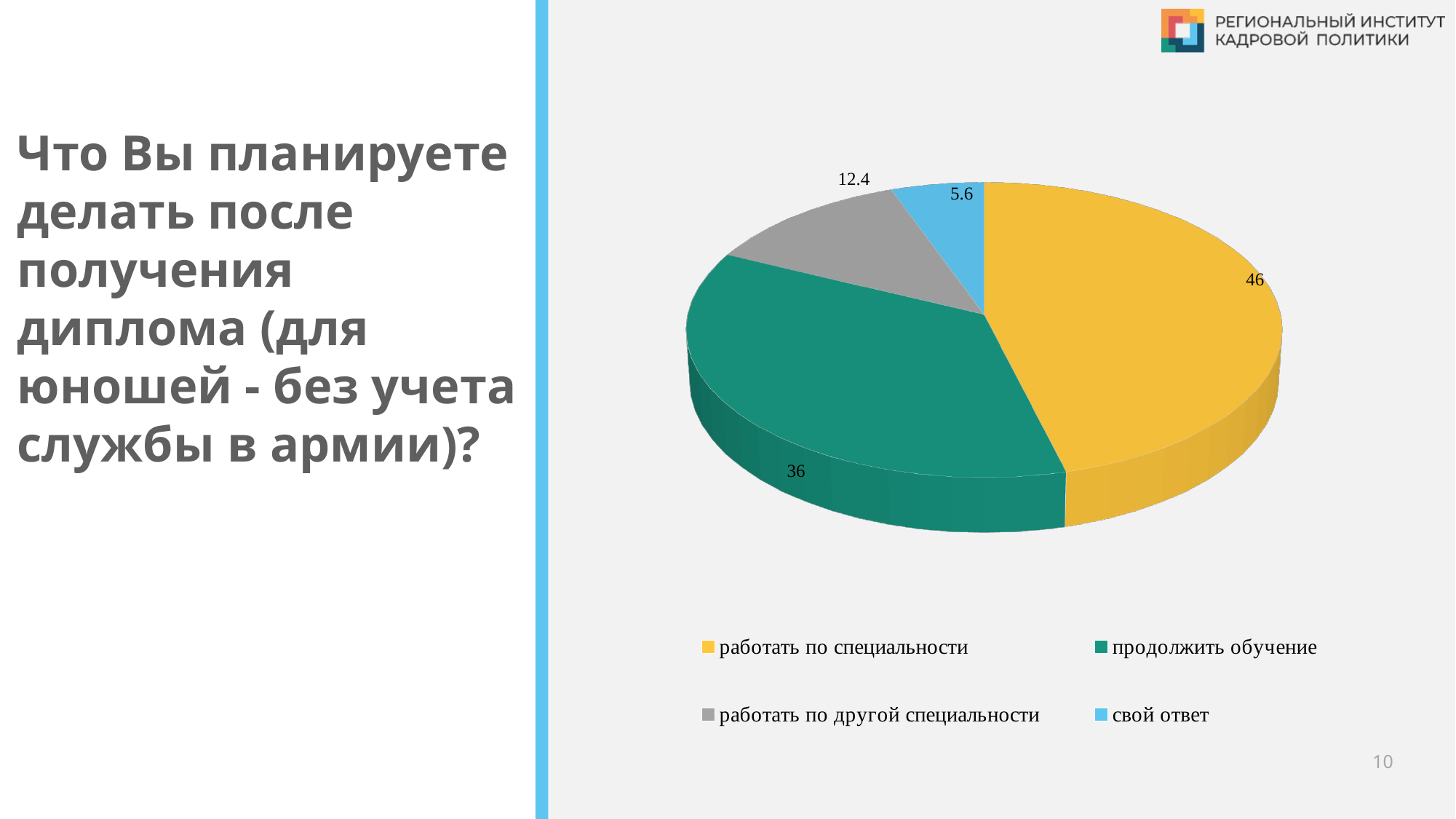
What is the value for "свой ответ"? 5.6 Which is larger: the value for "продолжить обучение" or the value for "работать по другой специальности"? продолжить обучение How many categories does the pie chart have? 4 What is the value for "продолжить обучение"? 36 What is the difference between the values for "работать по другой специальности" and "свой ответ"? 6.8 What is the value for "работать по другой специальности"? 12.4 Which category has the largest slice of the pie? работать по специальности Which category has the smallest slice of the pie? свой ответ What colour is the slice for "свой ответ"? light blue What is the value for "работать по специальности"? 46 What type of chart is shown on the slide? pie chart What is the difference between the values for "работать по специальности" and "продолжить обучение"? 10